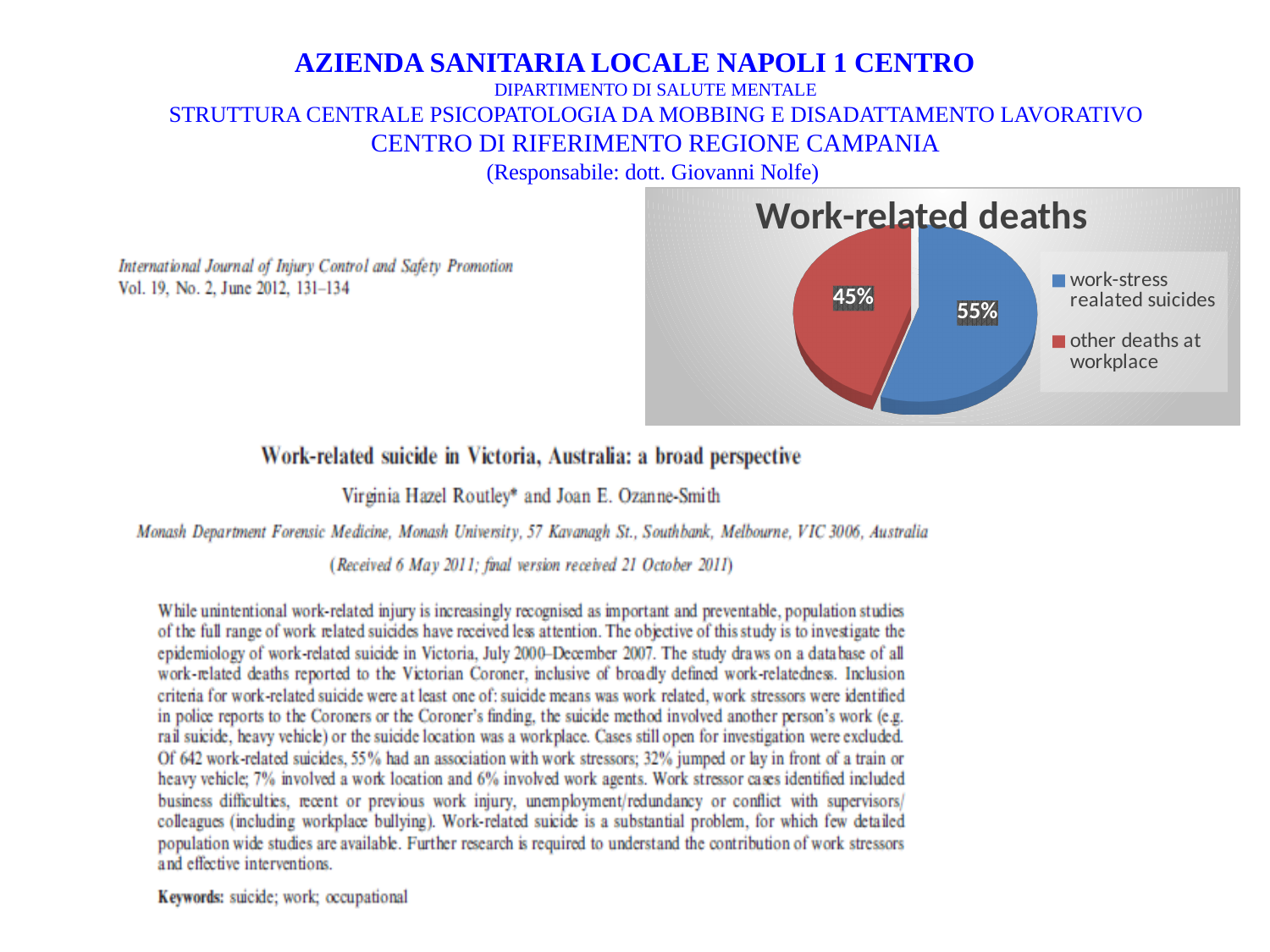
What is the difference in percentage points between the work-stress realated suicides slice and the other deaths at workplace slice? 10 How many entries does the chart legend list? 2 How many slices does the pie chart have? 2 What percentage of the pie is labelled for other deaths at workplace? 45% Which is larger: the work-stress realated suicides slice or the other deaths at workplace slice? work-stress realated suicides What colour is the slice for other deaths at workplace? red What is the title of the chart on the slide? Work-related deaths Which slice of the pie is the smallest? other deaths at workplace Which slice of the pie is the largest? work-stress realated suicides What kind of chart is shown on the slide? pie chart What percentage of the pie is labelled for work-stress realated suicides? 55%